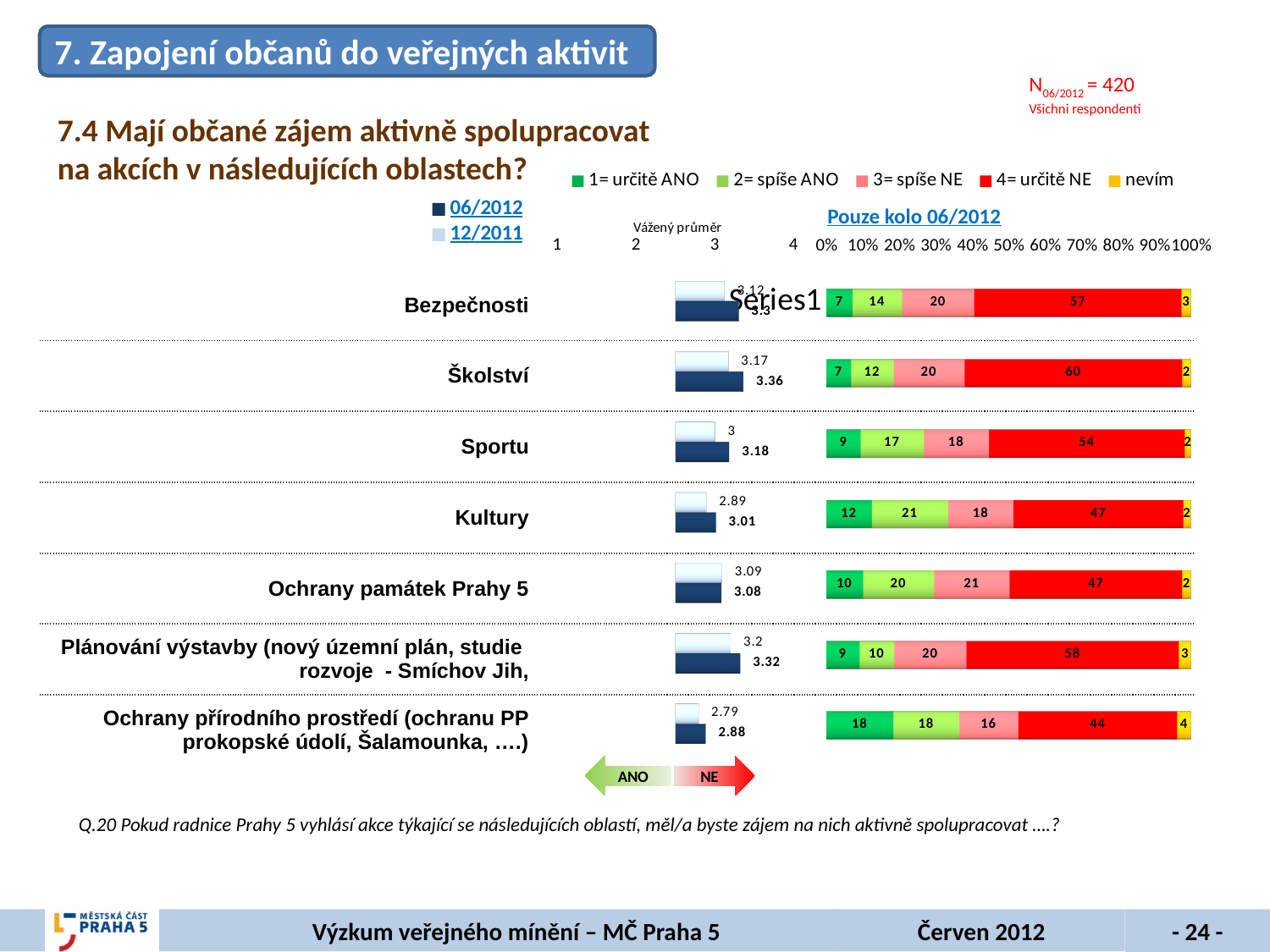
In the stacked bar chart 'Pouze kolo 06/2012', how many series does the legend list? 5 In the stacked bar chart 'Pouze kolo 06/2012', what is the difference between '4= určitě NE' for Bezpečnosti and for Kultury? 10 In the stacked bar chart 'Pouze kolo 06/2012', what is the total of the stacked bar for Sportu? 100 In the 'Vážený průměr' bar chart, what is the 06/2012 value for Školství? 3.36 In the stacked bar chart 'Pouze kolo 06/2012', what is the value of '4= určitě NE' for Školství? 60 In the 'Vážený průměr' bar chart, what is the difference between the 06/2012 and 12/2011 values for Plánování výstavby? 0.12 In the stacked bar chart 'Pouze kolo 06/2012', which category has the lowest value for '4= určitě NE'? Ochrany přírodního prostředí In the stacked bar chart 'Pouze kolo 06/2012', which category has the highest value for '4= určitě NE'? Školství What kind of chart is the 'Pouze kolo 06/2012' chart? Stacked bar chart In the 'Vážený průměr' bar chart, which is larger for Sportu: the 06/2012 value or the 12/2011 value? 06/2012 In the 'Vážený průměr' bar chart, what is the 12/2011 value for Kultury? 2.89 In the stacked bar chart 'Pouze kolo 06/2012', what is the value of '1= určitě ANO' for Ochrany přírodního prostředí? 18